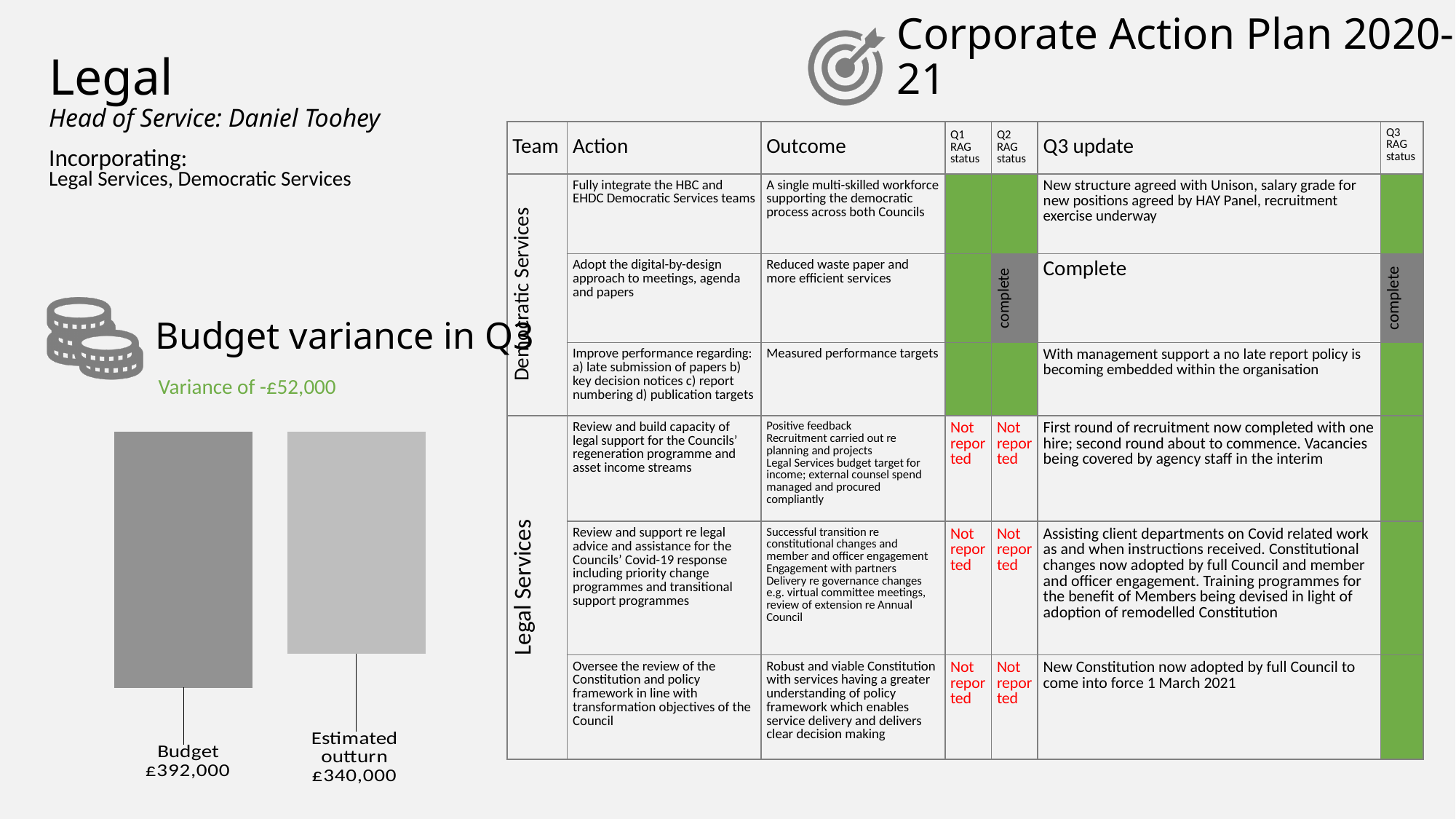
Which bar is lower in the Budget variance in Q3 chart? Estimated outturn Which bar is higher in the Budget variance in Q3 chart? Budget What is the value of the Estimated outturn bar in the Budget variance in Q3 chart? £340,000 What kind of chart is the Budget variance in Q3 chart? bar chart What variance is stated beneath the Budget variance in Q3 chart title? Variance of -£52,000 How many bars are shown in the Budget variance in Q3 chart? 2 What is the title of the chart on the left of the slide? Budget variance in Q3 What is the value of the Budget bar in the Budget variance in Q3 chart? £392,000 What is the difference between the Budget and the Estimated outturn in the Budget variance in Q3 chart? £52,000 Is the Budget larger or smaller than the Estimated outturn in the Budget variance in Q3 chart? larger Do the values fall or rise from the Budget bar to the Estimated outturn bar in the Budget variance in Q3 chart? fall